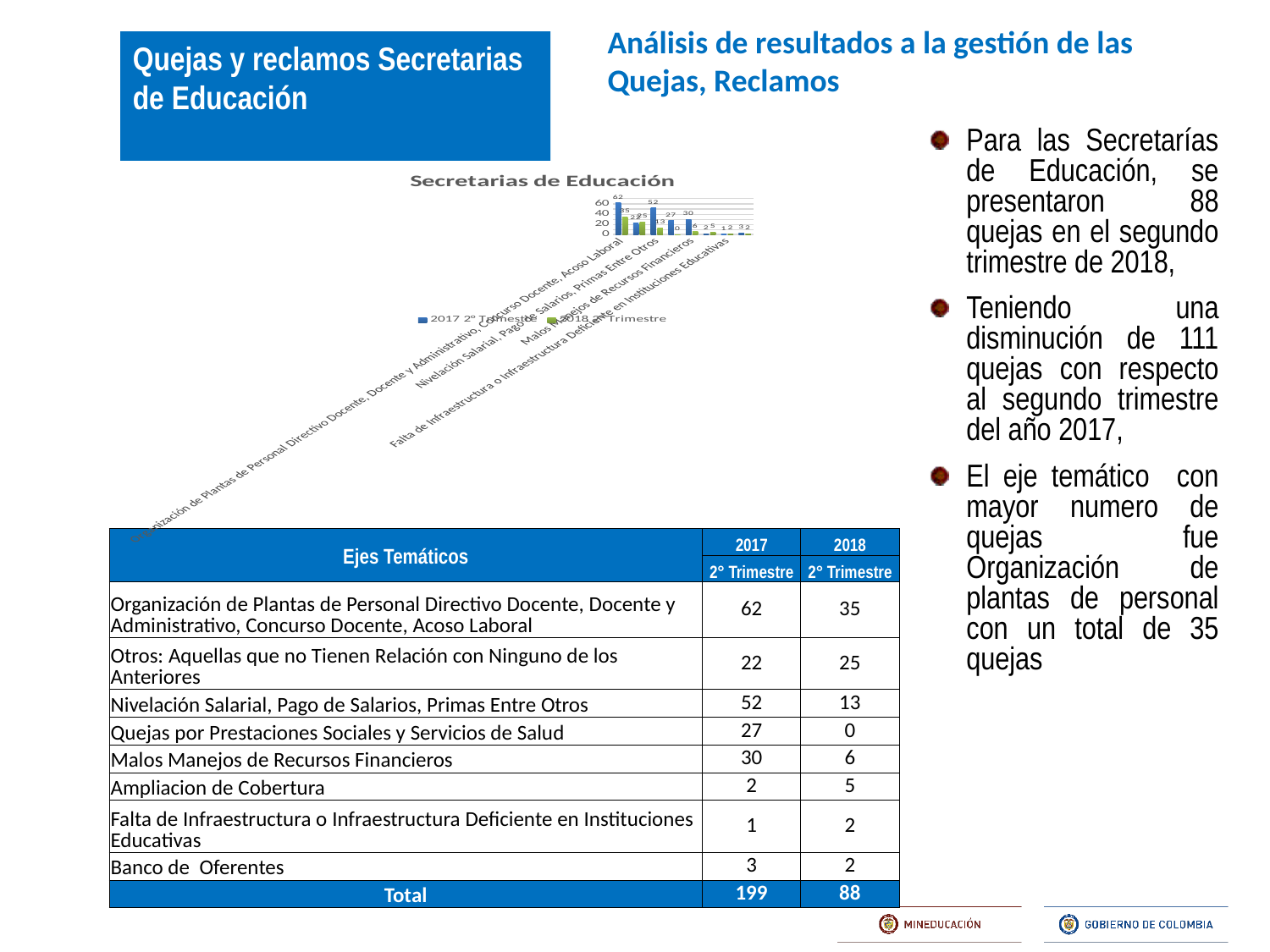
In the "Secretarias de Educación" chart, what is the highest value shown on the vertical axis? 60 Which two series are listed in the legend of the "Secretarias de Educación" chart? 2017 2° Trimestre and 2018 2° Trimestre How many series does the legend of the "Secretarias de Educación" chart list? 2 In the "Secretarias de Educación" chart, which is larger for "Nivelación Salarial, Pago de Salarios, Primas Entre Otros": the 2017 2° Trimestre value or the 2018 2° Trimestre value? 2017 2° Trimestre In the "Secretarias de Educación" chart, what is the highest value shown for the 2017 2° Trimestre series? 62 In the "Secretarias de Educación" chart, what is the 2017 2° Trimestre value for "Malos Manejos de Recursos Financieros"? 30 What kind of chart is shown under the title "Secretarias de Educación"? bar chart In the "Secretarias de Educación" chart, what is the difference between the 2017 and 2018 2° Trimestre values for "Malos Manejos de Recursos Financieros"? 24 In the "Secretarias de Educación" chart, what is the 2018 2° Trimestre value for "Malos Manejos de Recursos Financieros"? 6 In the "Secretarias de Educación" chart, is the highest 2017 2° Trimestre value greater or less than 40? greater In the "Secretarias de Educación" chart, what is the 2017 2° Trimestre value for "Nivelación Salarial, Pago de Salarios, Primas Entre Otros"? 52 What is the title of the chart on the slide? Secretarias de Educación